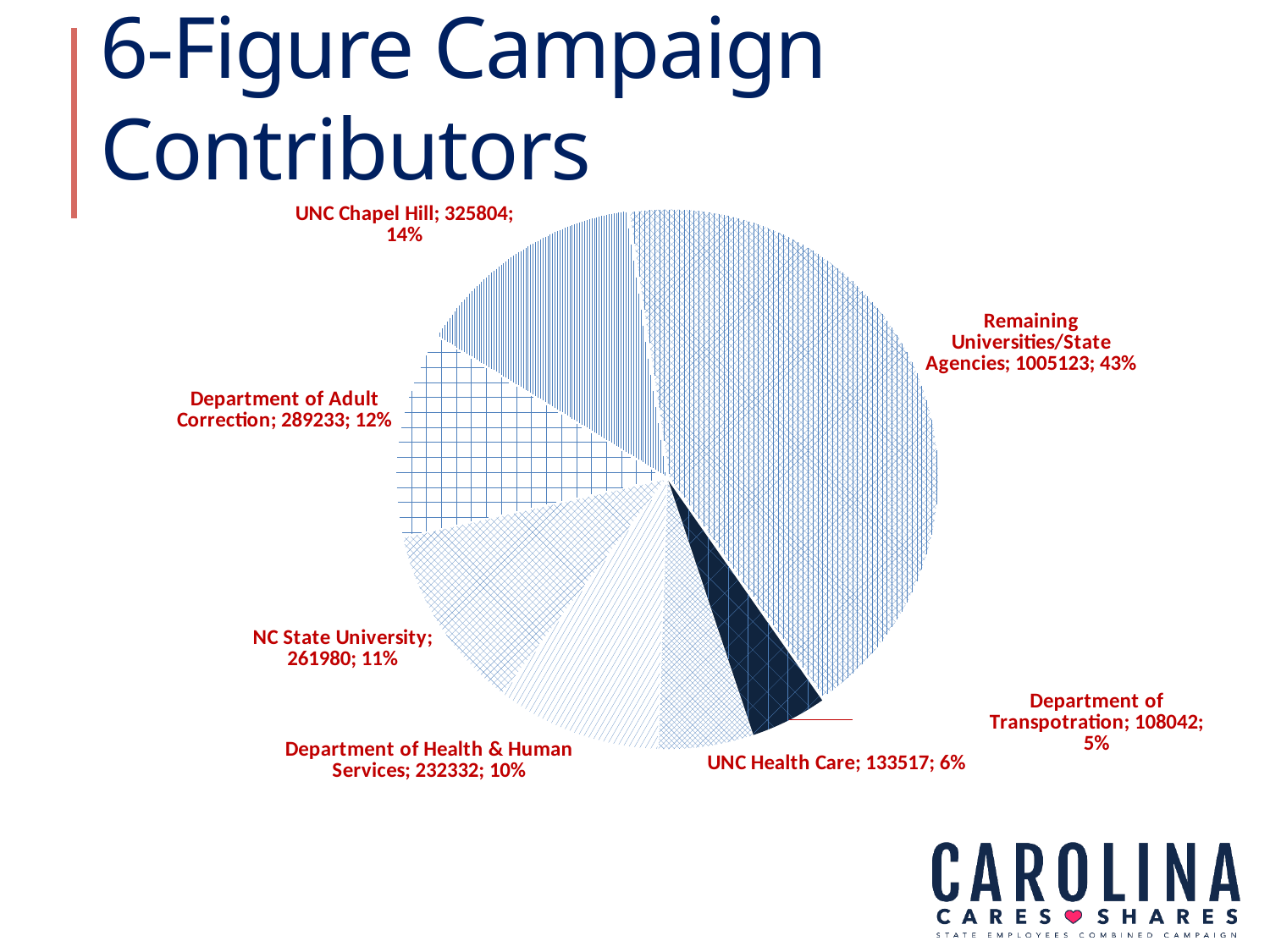
What is the difference between the values for UNC Chapel Hill and NC State University? 63824 What share of the pie does NC State University represent? 11% What is the value for UNC Chapel Hill? 325804 Which category has the smallest slice? Department of Transpotration What is the value for Department of Adult Correction? 289233 What is the title of the slide containing the pie chart? 6-Figure Campaign Contributors What type of chart is shown on the slide? pie chart What share of the pie does Remaining Universities/State Agencies represent? 43% Which is larger, the value for Department of Health & Human Services or the value for UNC Health Care? Department of Health & Human Services Which category has the largest slice? Remaining Universities/State Agencies How many slices does the pie chart have? 7 What is the value for UNC Health Care? 133517